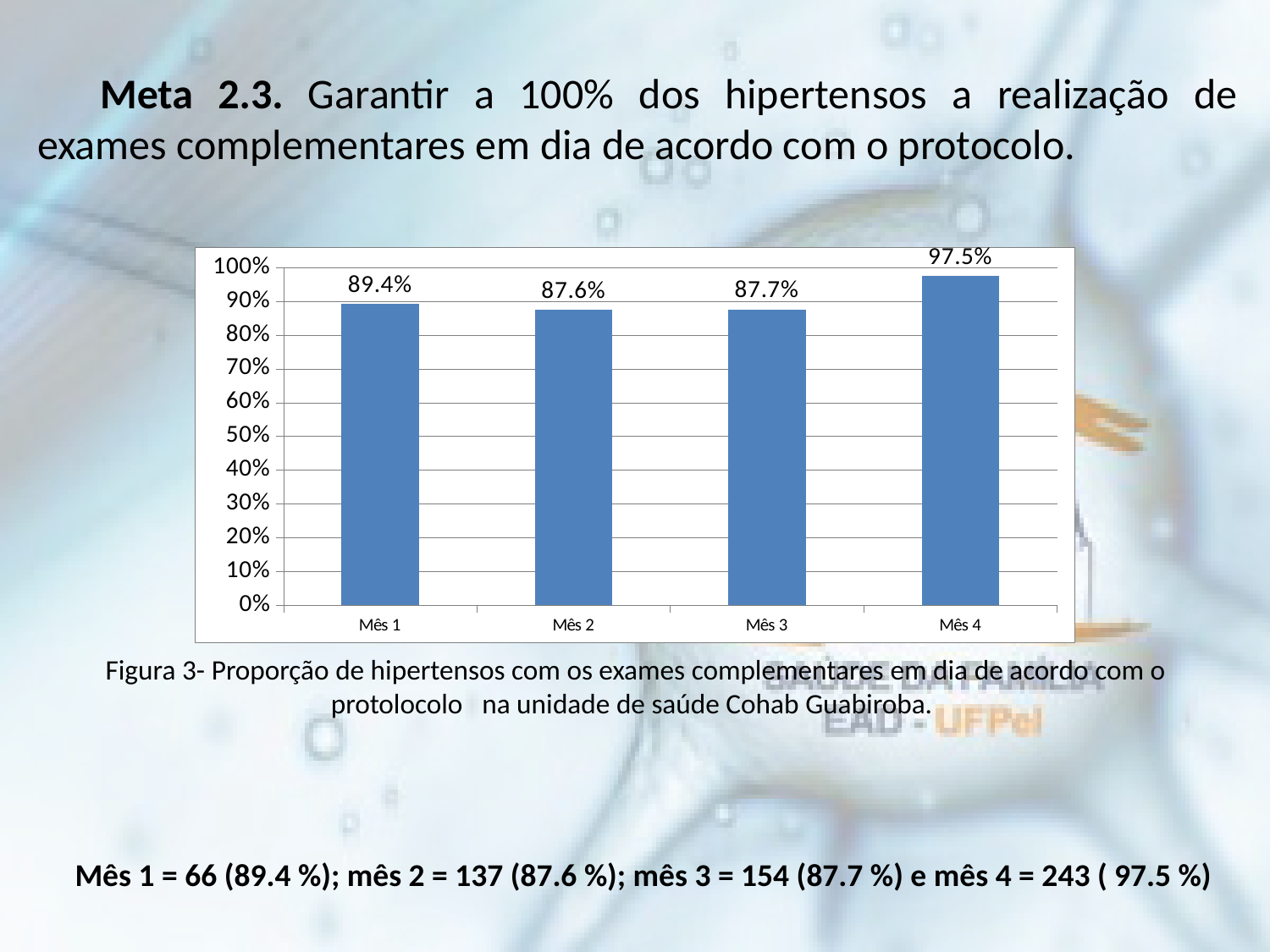
What is the value for Mês 1? 89.4% What is the value for Mês 3? 87.7% Which is larger, the value for Mês 1 or the value for Mês 4? Mês 4 How many categories are shown on the x axis? 4 Does the value rise or fall from Mês 3 to Mês 4? rise Which month has the highest value? Mês 4 What is the value for Mês 2? 87.6% Is the value for Mês 4 greater or less than 90%? greater What kind of chart is shown on the slide? bar chart What is the difference between the values for Mês 4 and Mês 2? 9.9 percentage points What is the difference between the values for Mês 4 and Mês 1? 8.1 percentage points What is the value for Mês 4? 97.5%